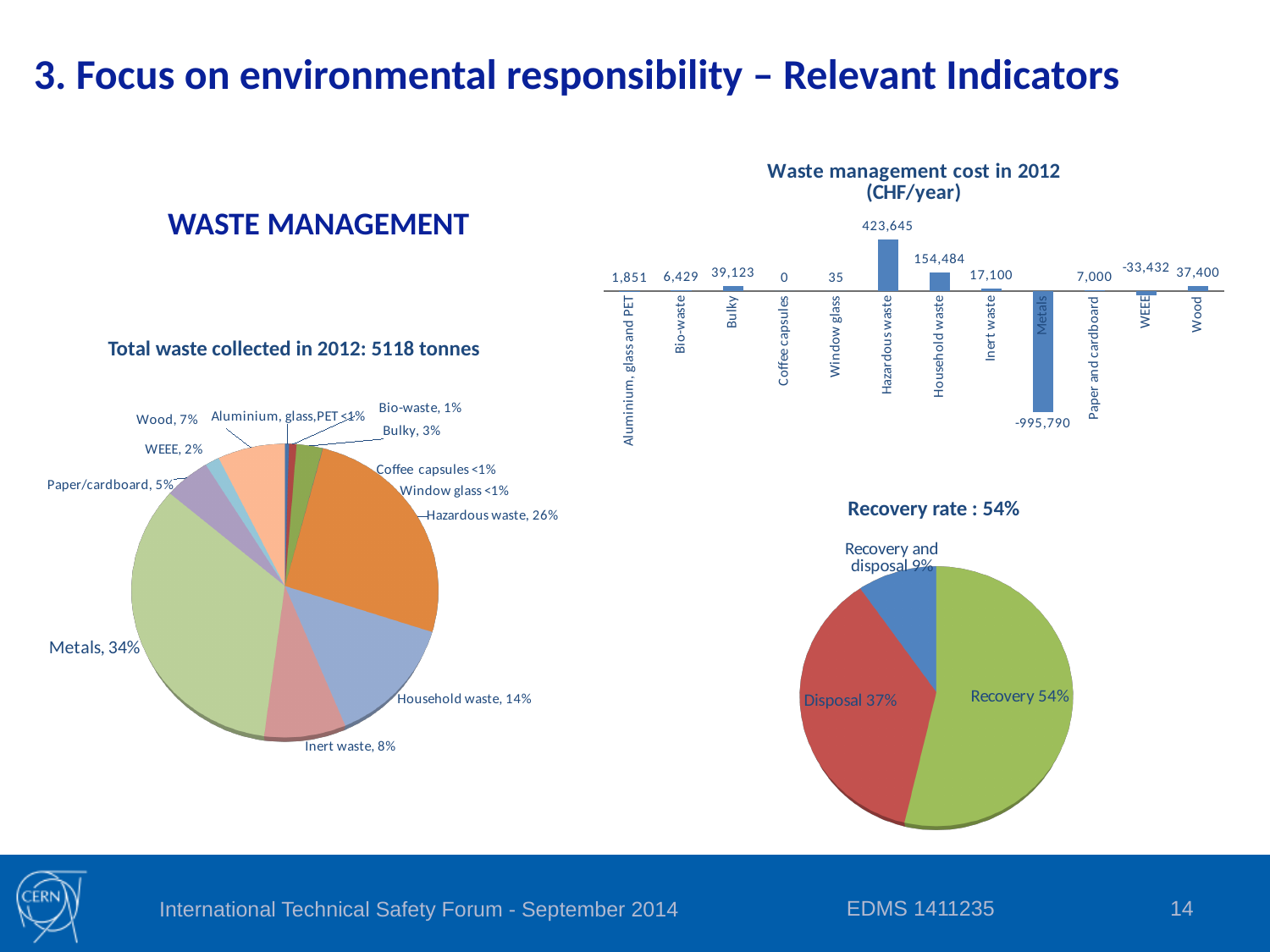
In the 'Total waste collected in 2012: 5118 tonnes' pie chart, which category has the largest slice? Metals In the 'Waste management cost in 2012 (CHF/year)' chart, which category has the lowest value? Metals How many slices does the 'Recovery rate : 54%' pie chart have? 3 In the 'Waste management cost in 2012 (CHF/year)' chart, what is the value for Hazardous waste? 423,645 How many categories are shown in the 'Waste management cost in 2012 (CHF/year)' chart? 12 What kind of chart is the 'Waste management cost in 2012 (CHF/year)' chart? Bar chart In the 'Waste management cost in 2012 (CHF/year)' chart, which is larger, the value for Bulky or the value for Wood? Bulky In the 'Waste management cost in 2012 (CHF/year)' chart, what is the difference between the values for Hazardous waste and Household waste? 269,161 In the 'Recovery rate : 54%' pie chart, what share does Disposal have? 37% In the 'Waste management cost in 2012 (CHF/year)' chart, what is the value for Metals? -995,790 In the 'Waste management cost in 2012 (CHF/year)' chart, which category has the highest value? Hazardous waste In the 'Total waste collected in 2012: 5118 tonnes' pie chart, what share does Metals have? 34%